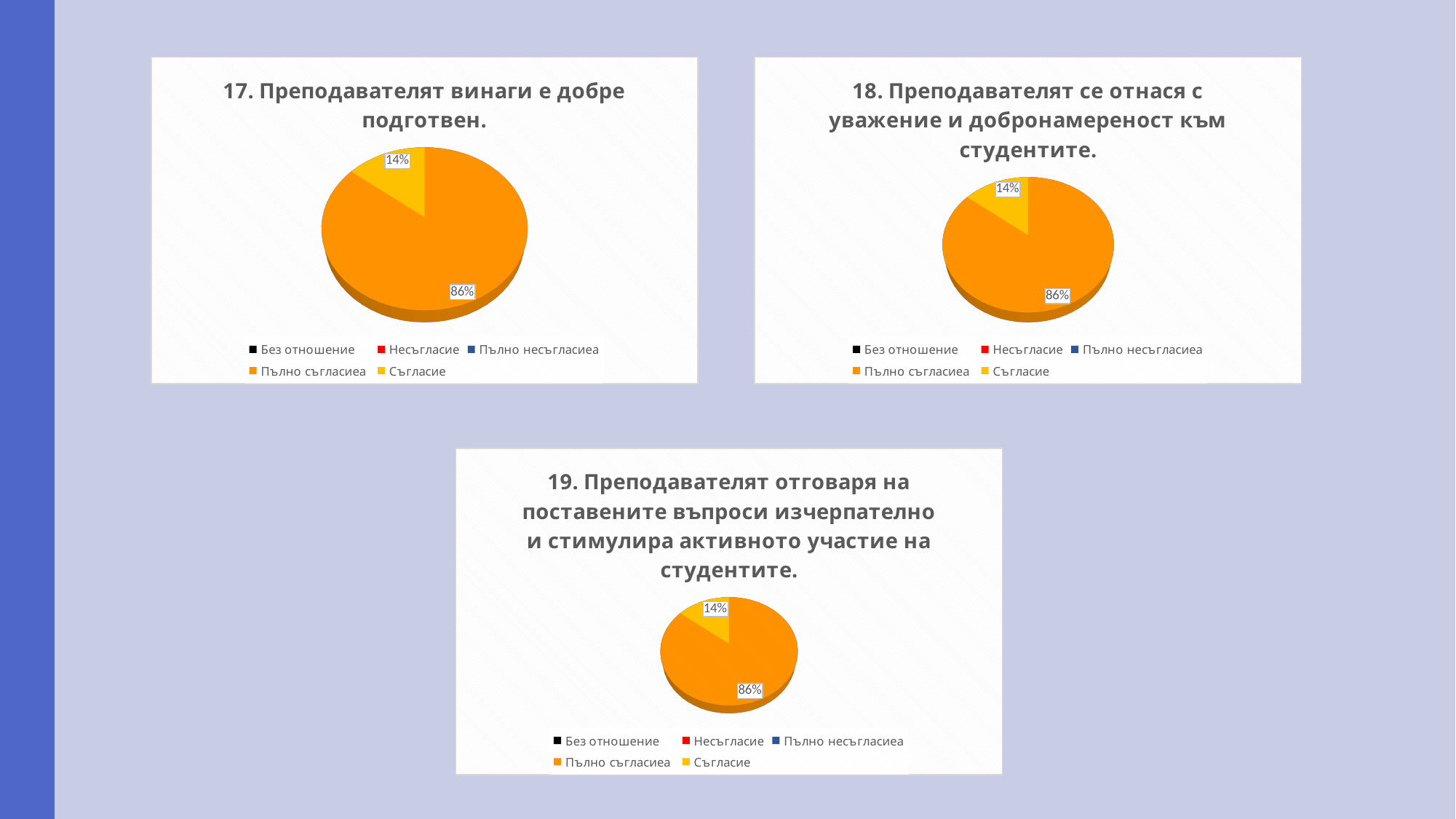
In the chart titled "17. Преподавателят винаги е добре подготвен.", which is larger, "Съгласие" or "Пълно съгласиеа"? Пълно съгласиеа How many entries does the legend list in the chart titled "18. Преподавателят се отнася с уважение и добронамереност към студентите."? 5 In the chart titled "17. Преподавателят винаги е добре подготвен.", what share of the pie is "Пълно съгласиеа"? 86% In the chart titled "19. Преподавателят отговаря на поставените въпроси изчерпателно и стимулира активното участие на студентите.", which category has the largest slice? Пълно съгласиеа In the chart titled "18. Преподавателят се отнася с уважение и добронамереност към студентите.", what is the value for "Пълно съгласиеа"? 86% In the chart titled "18. Преподавателят се отнася с уважение и добронамереност към студентите.", what is the value for "Съгласие"? 14% How many slices with data labels are visible in the chart titled "19. Преподавателят отговаря на поставените въпроси изчерпателно и стимулира активното участие на студентите."? 2 In the chart titled "17. Преподавателят винаги е добре подготвен.", what share of the pie is "Съгласие"? 14% What kind of chart is the chart titled "17. Преподавателят винаги е добре подготвен."? Pie chart How many pie charts are shown on the slide? 3 In the chart titled "18. Преподавателят се отнася с уважение и добронамереност към студентите.", what colour is the "Съгласие" slice? Yellow In the chart titled "19. Преподавателят отговаря на поставените въпроси изчерпателно и стимулира активното участие на студентите.", what is the difference between the "Пълно съгласиеа" and "Съгласие" slices? 72%